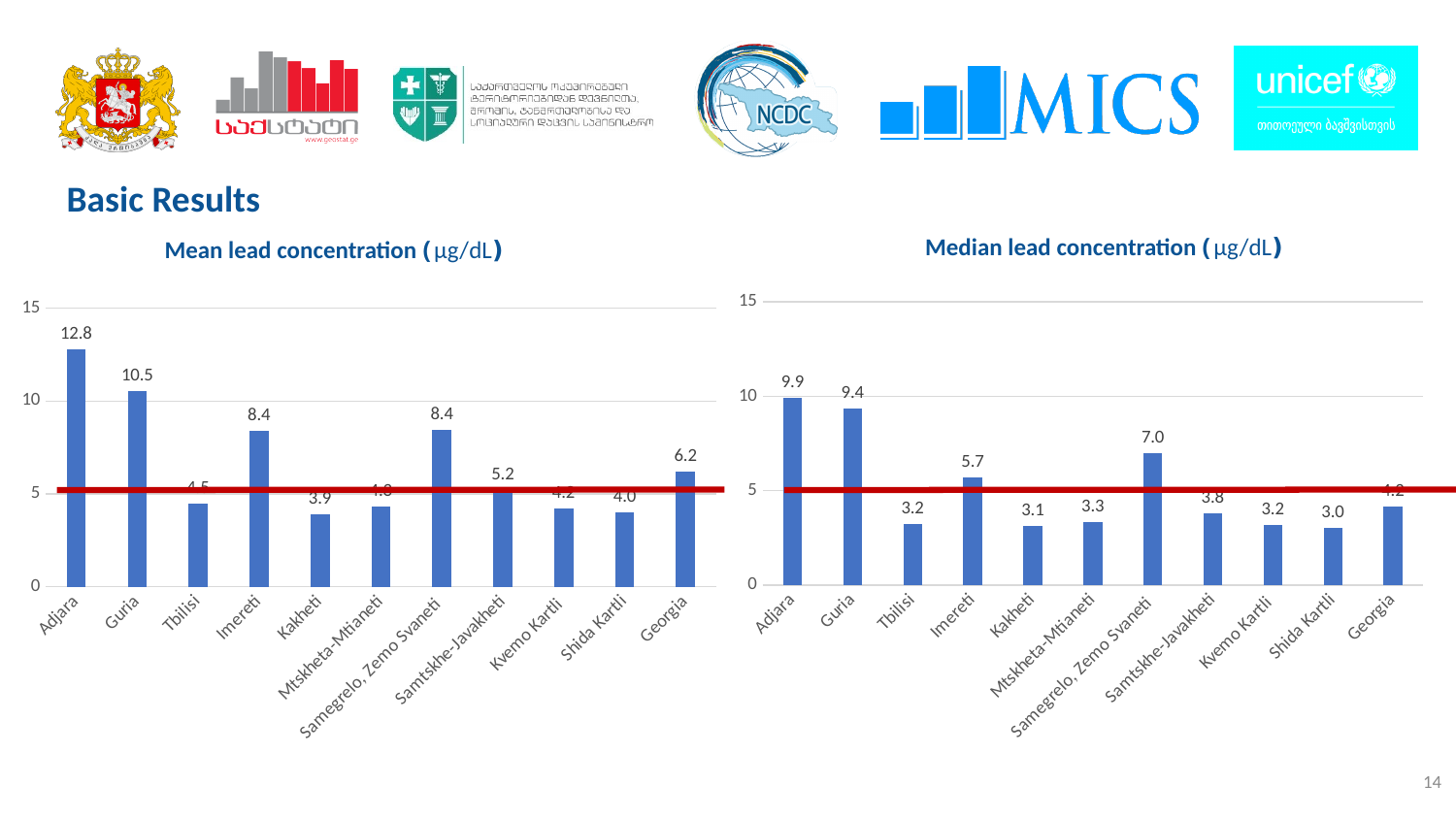
In the Mean lead concentration chart, what is the value for Adjara? 12.8 In the Mean lead concentration chart, which region has the highest value? Adjara In the Median lead concentration chart, what is the value for Tbilisi? 3.2 In the Mean lead concentration chart, what is the value for Georgia? 6.2 In the Mean lead concentration chart, what is the difference between the values for Adjara and Guria? 2.3 How many categories are shown on the x axis of the Median lead concentration chart? 11 In the Median lead concentration chart, what is the value for Samegrelo, Zemo Svaneti? 7.0 What is the title of the chart on the right side of the slide? Median lead concentration (μg/dL) In the Median lead concentration chart, which region has the highest value? Adjara In the Mean lead concentration chart, is the value for Kakheti greater or less than 5? less In the Median lead concentration chart, which is larger, the value for Imereti or the value for Samtskhe-Javakheti? Imereti What kind of chart is the Mean lead concentration chart? bar chart